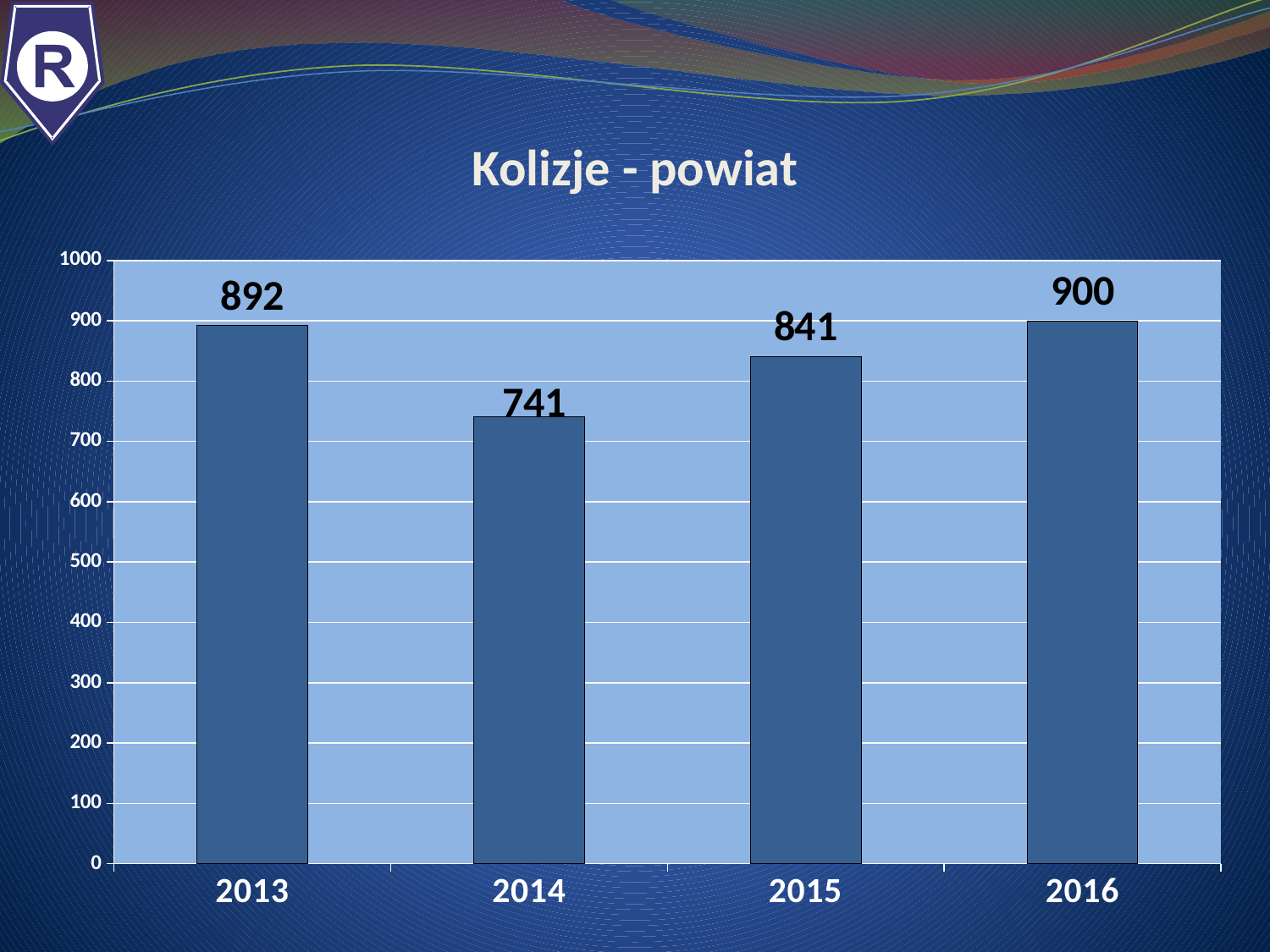
Which year has the lowest value? 2014 Which is larger, the value for 2013 or the value for 2015? 2013 What is the title of the chart? Kolizje - powiat What is the value for 2014? 741 What kind of chart is shown on the slide? bar chart What is the value for 2015? 841 Which year has the highest value? 2016 What is the value for 2016? 900 What is the value for 2013? 892 How many years are shown on the chart? 4 What is the difference between the values for 2013 and 2015? 51 What is the difference between the values for 2016 and 2014? 159